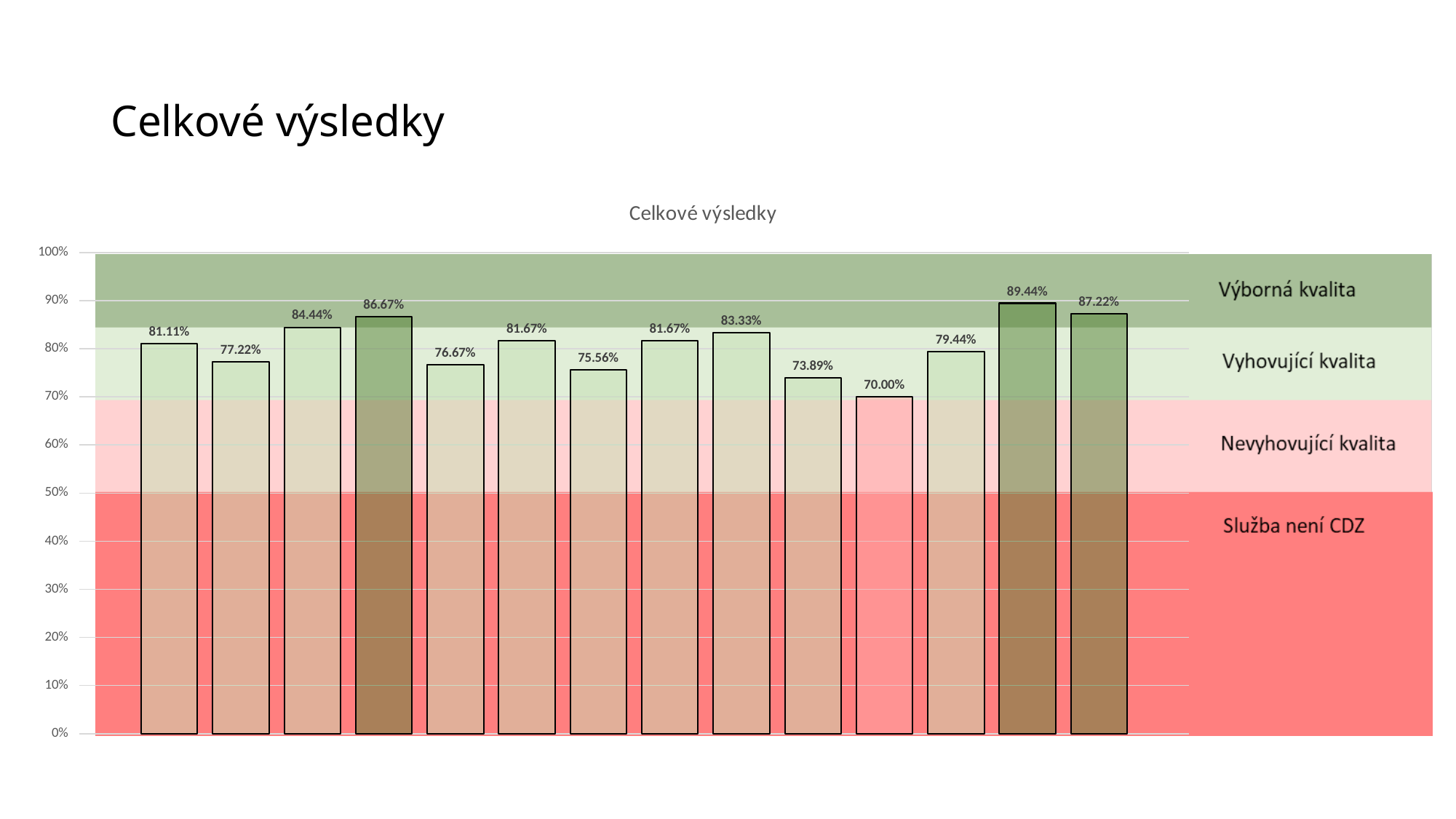
What kind of chart is shown on the slide? bar chart What is the value of the last (rightmost) bar? 87.22% What is the lowest value shown in the chart? 70.00% What is the difference between the highest bar (89.44%) and the lowest bar (70.00%)? 19.44% What is the highest value shown in the chart? 89.44% Which quality band label is shown at the top of the chart's background? Výborná kvalita What is the value of the fourth bar from the left? 86.67% What is the value of the first (leftmost) bar? 81.11% How many bars are plotted in the chart? 14 Which is larger, the second bar from the left (77.22%) or the third bar from the left (84.44%)? the third bar (84.44%) What is the title of the chart? Celkové výsledky Is the value of the eleventh bar from the left greater or less than 80%? less